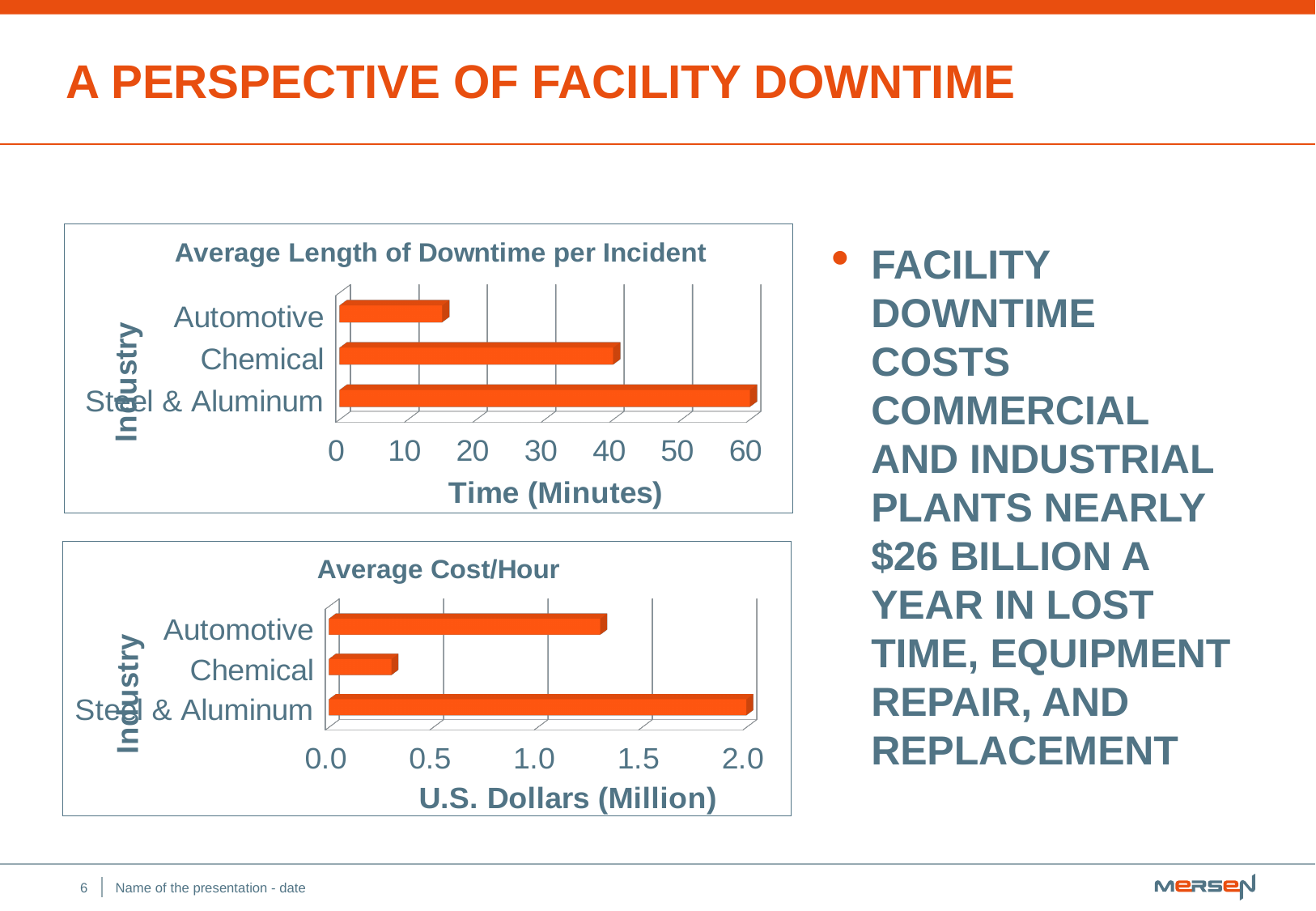
In the 'Average Cost/Hour' chart, is the value for Automotive greater or less than 1.0? greater In the 'Average Length of Downtime per Incident' chart, which industry has the shortest average downtime? Automotive In the 'Average Cost/Hour' chart, which industry has the highest average cost per hour? Steel & Aluminum In the 'Average Cost/Hour' chart, is the value for Chemical greater or less than 0.5? less What type of chart is the 'Average Cost/Hour' chart? bar chart In the 'Average Length of Downtime per Incident' chart, is the value for Automotive greater or less than 20? less In the 'Average Length of Downtime per Incident' chart, which is larger, the value for Chemical or the value for Automotive? Chemical In the 'Average Length of Downtime per Incident' chart, which industry has the longest average downtime? Steel & Aluminum How many industries are shown in the 'Average Length of Downtime per Incident' chart? 3 In the 'Average Cost/Hour' chart, which is larger, the value for Automotive or the value for Chemical? Automotive In the 'Average Cost/Hour' chart, which industry has the lowest average cost per hour? Chemical